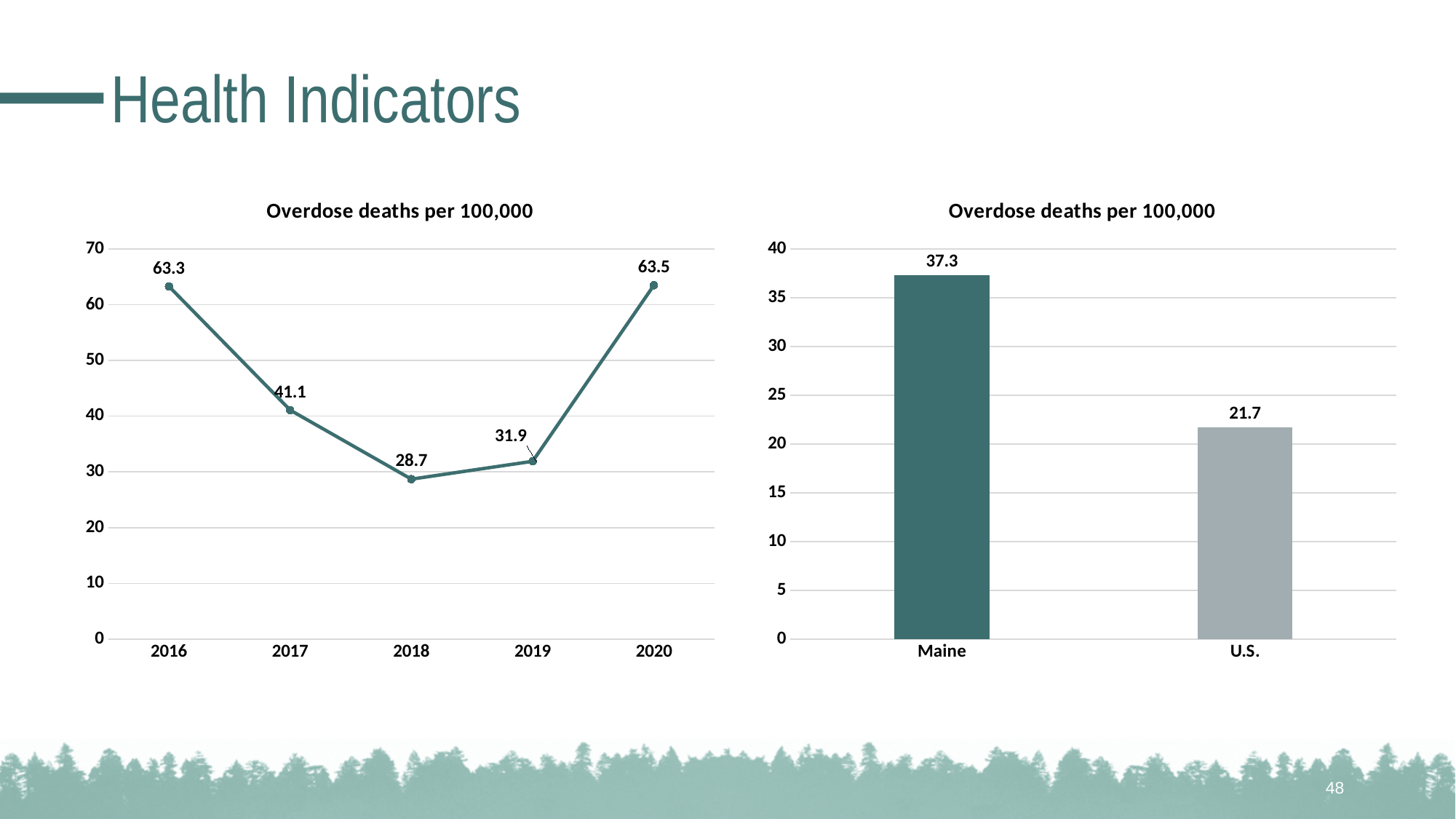
In the line chart on the left, what is the difference between the 2020 value and the 2019 value? 31.6 In the line chart on the left, how many years are plotted on the x axis? 5 In the bar chart on the right, what is the value for Maine? 37.3 In the line chart on the left, do the values rise or fall from 2016 to 2018? fall In the line chart on the left, what is the value for 2018? 28.7 In the bar chart on the right, which is larger, Maine or U.S.? Maine In the line chart on the left, what is the value for 2016? 63.3 What kind of chart is the chart on the right? bar chart In the bar chart on the right, what is the value for U.S.? 21.7 In the line chart on the left, which year has the lowest value? 2018 In the bar chart on the right, what is the difference between the Maine value and the U.S. value? 15.6 In the line chart on the left, which year has the highest value? 2020